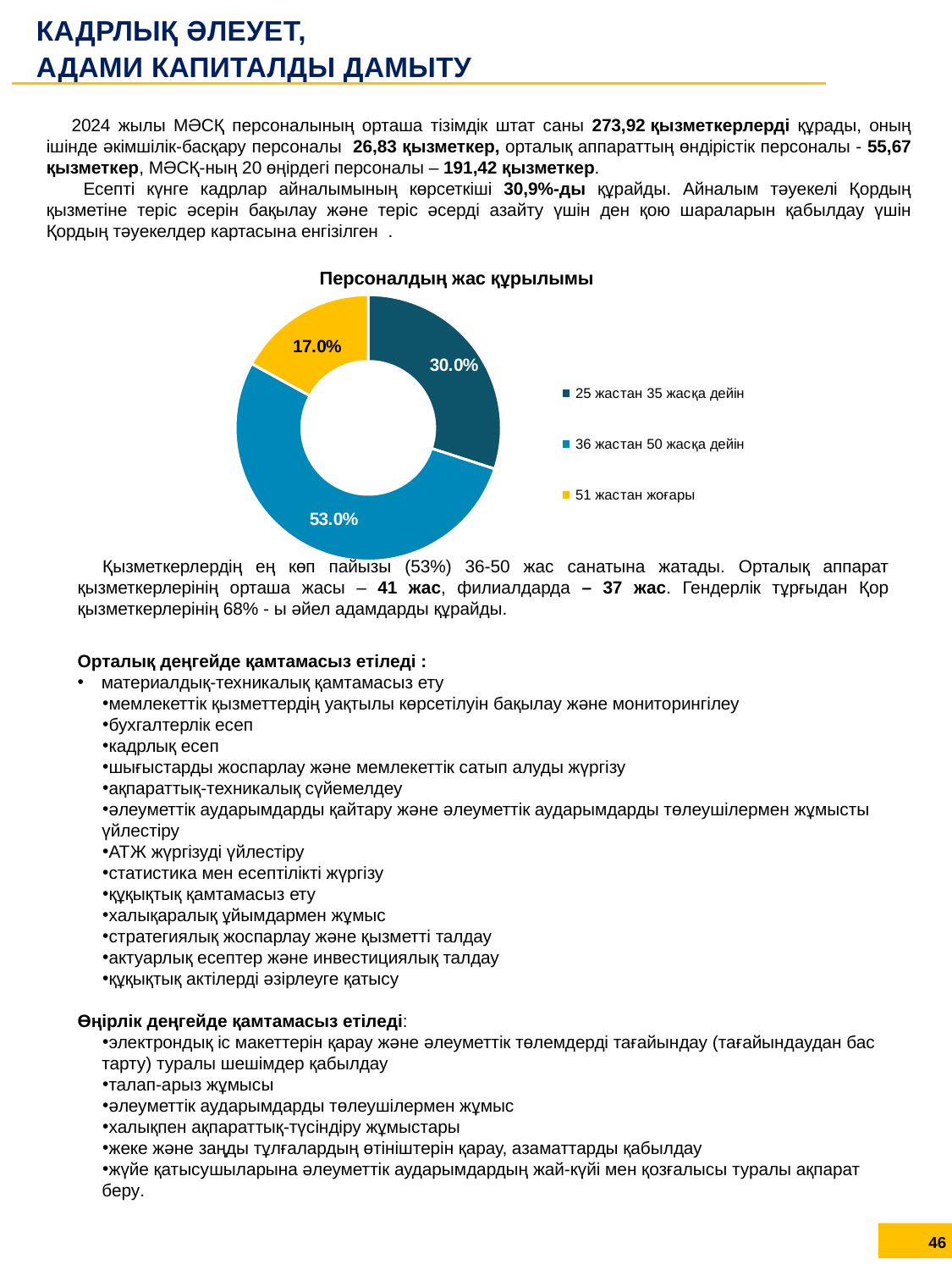
What share of personnel is in the "36 жастан 50 жасқа дейін" category? 53.0% What is the title of the chart on the slide? Персоналдың жас құрылымы What is the combined share of the "25 жастан 35 жасқа дейін" and "51 жастан жоғары" categories? 47.0% What share of personnel is in the "51 жастан жоғары" category? 17.0% What is the difference in percentage points between the "36 жастан 50 жасқа дейін" and "25 жастан 35 жасқа дейін" categories? 23.0 percentage points How many age categories does the chart show? 3 What colour represents the "51 жастан жоғары" category in the chart? Yellow Which is larger: the share for "25 жастан 35 жасқа дейін" or for "51 жастан жоғары"? 25 жастан 35 жасқа дейін Which age category has the smallest share of personnel? 51 жастан жоғары What kind of chart is shown on the slide? Pie chart (doughnut) Which age category has the largest share of personnel? 36 жастан 50 жасқа дейін What share of personnel is in the "25 жастан 35 жасқа дейін" category? 30.0%